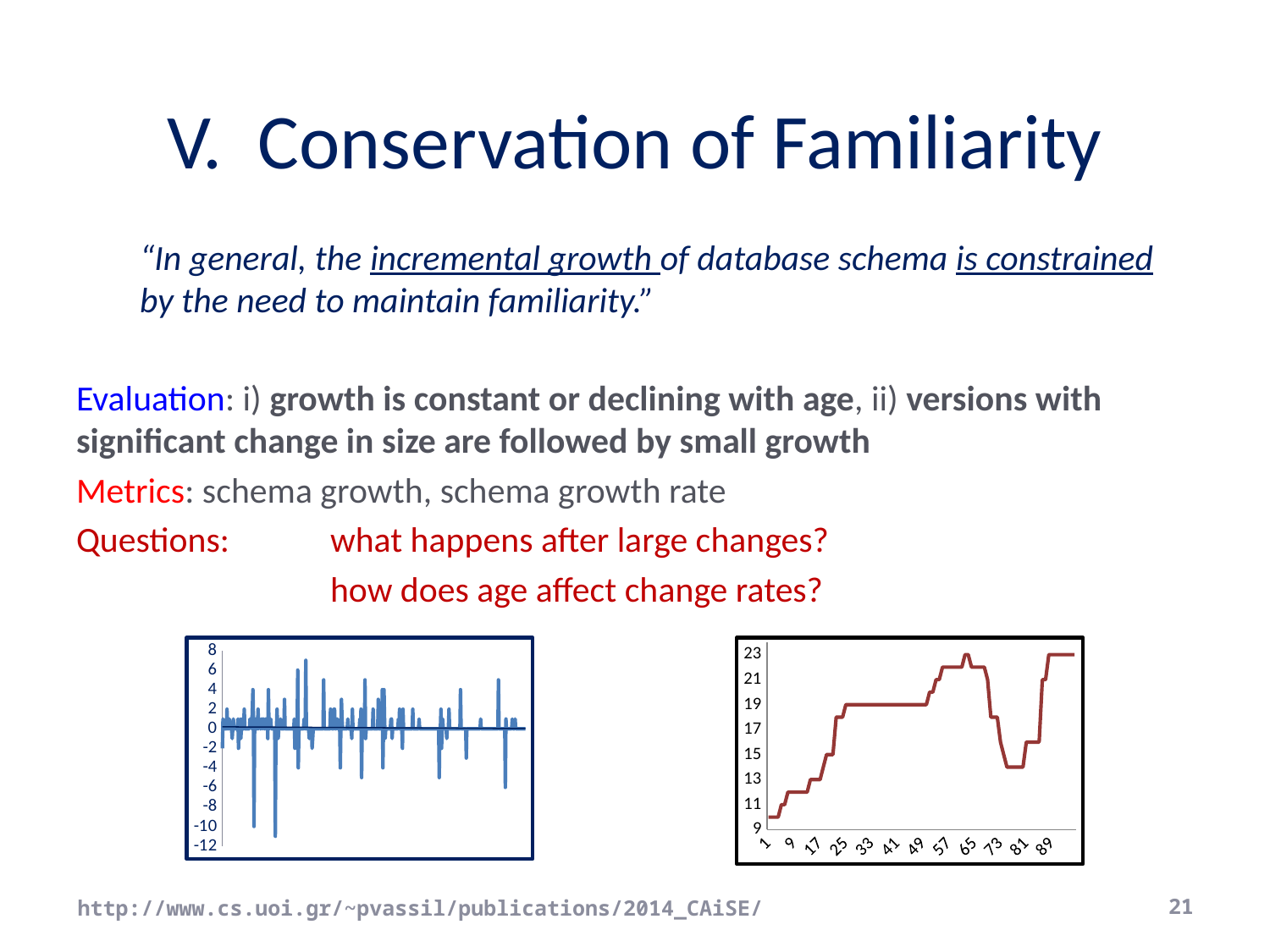
What kind of chart is the chart on the right of the slide? line chart In the chart on the left, is the highest value on the line greater or less than 4? greater In the chart on the right, is the value at x = 1 greater or less than 11? less What is the highest value shown on the y axis of the chart on the right? 23 In the chart on the left, is the lowest value on the line greater or less than -8? less What is the lowest value shown on the y axis of the chart on the left? -12 In the chart on the right, do the values overall rise or fall from the start of the x axis to the end? rise What kind of chart is the chart on the left of the slide? line chart